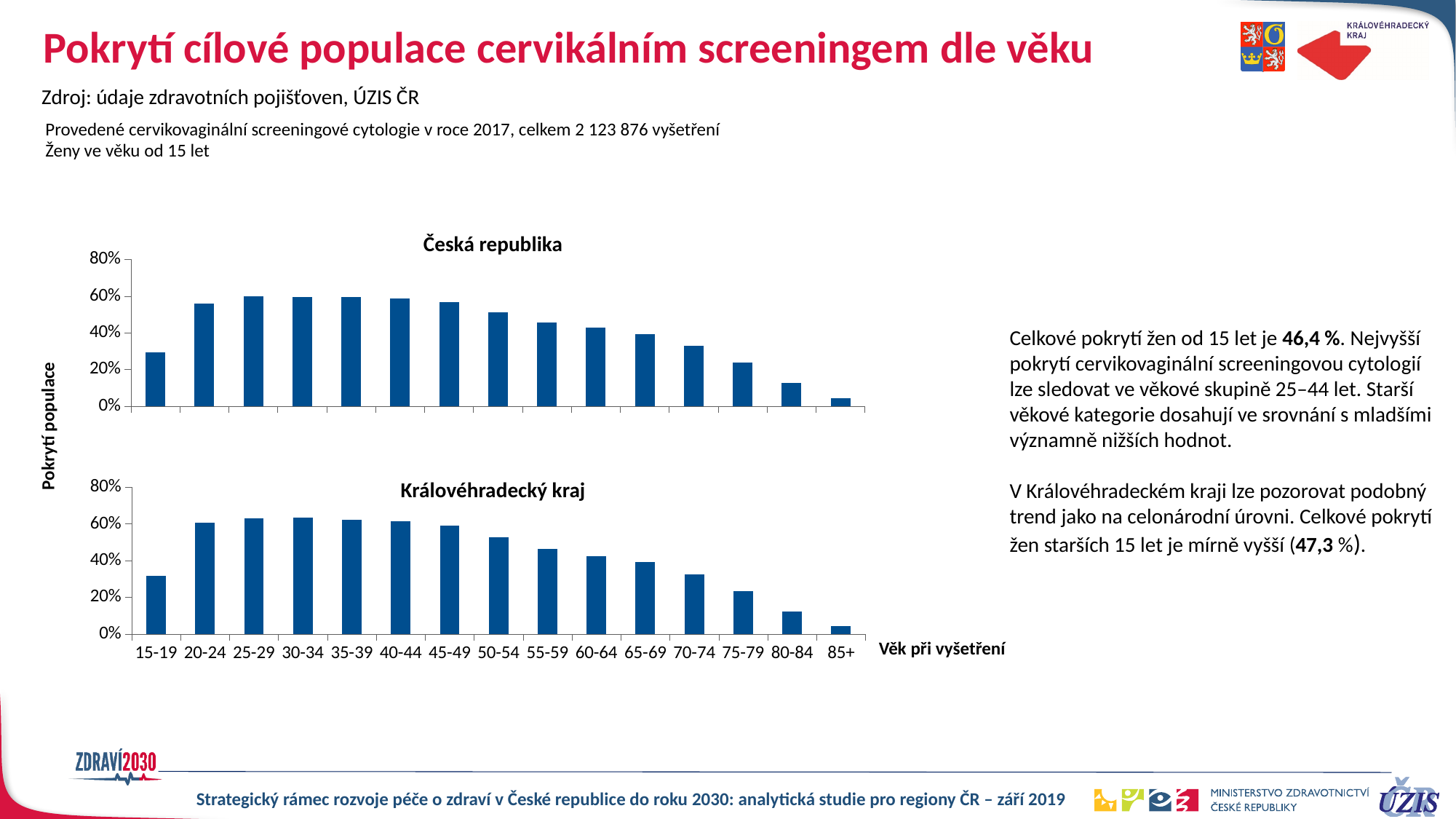
What kind of chart is the "Česká republika" chart? bar chart In the "Královéhradecký kraj" chart, which is larger, the value for 70-74 or the value for 75-79? 70-74 In the "Česká republika" chart, is the value for 50-54 greater or less than 40%? greater In the "Česká republika" chart, which age group has the lowest coverage? 85+ In the "Česká republika" chart, do the values rise or fall along the x axis from 45-49 to 85+? fall In the "Královéhradecký kraj" chart, is the value for 80-84 greater or less than 20%? less In the "Česká republika" chart, which is larger, the value for 15-19 or the value for 20-24? 20-24 In the "Česká republika" chart, is the value for 15-19 greater or less than 20%? greater In the "Královéhradecký kraj" chart, which age group has the lowest coverage? 85+ How many age categories are shown on the x axis of the "Královéhradecký kraj" chart? 15 What is the title of the lower chart on the slide? Královéhradecký kraj